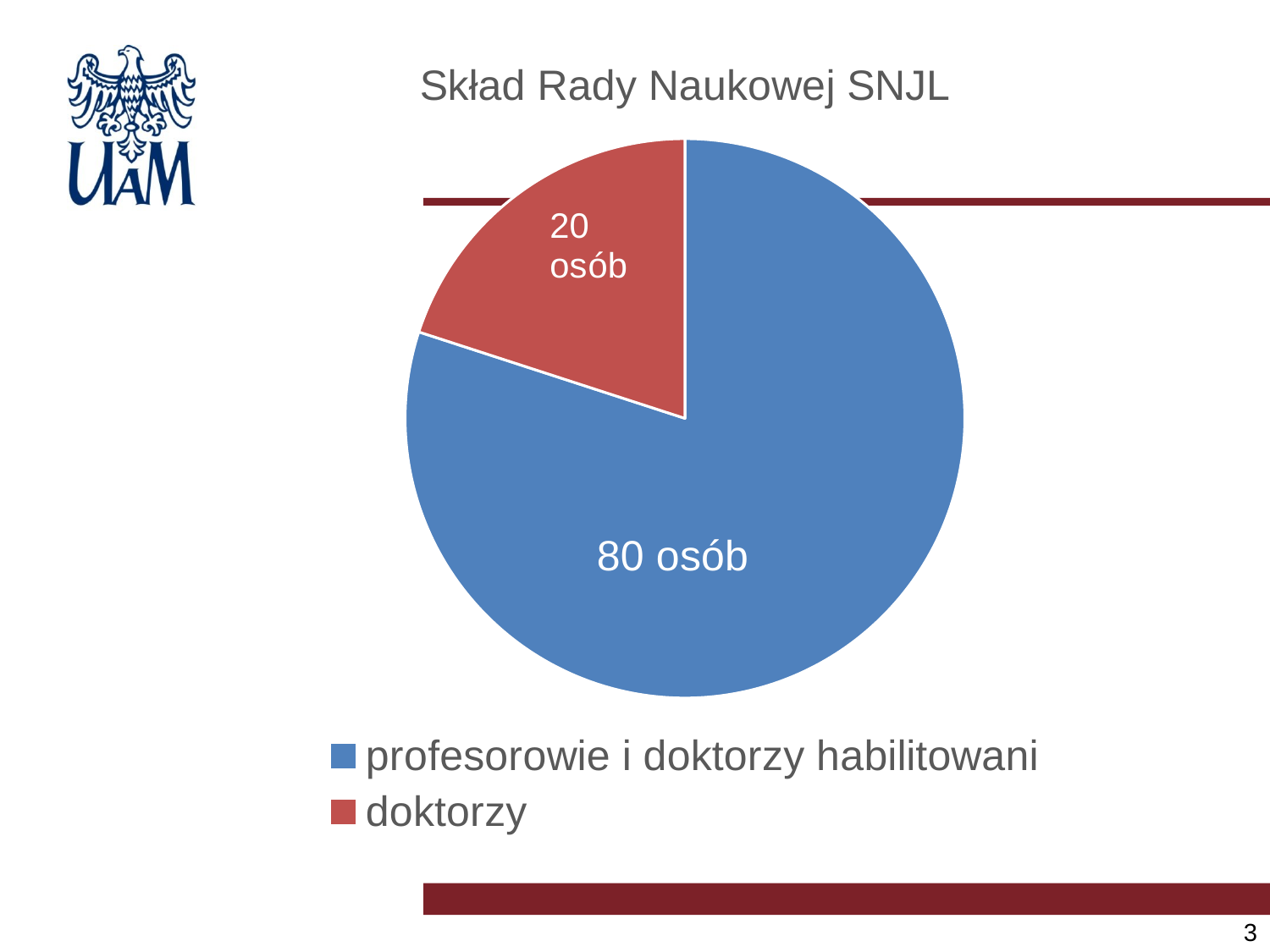
What colour is the slice for 'doktorzy'? red What is the title of the chart? Skład Rady Naukowej SNJL Which category has the smallest slice? doktorzy Which is larger, the value for 'doktorzy' or for 'profesorowie i doktorzy habilitowani'? profesorowie i doktorzy habilitowani What kind of chart is shown on the slide? pie chart How many slices does the pie chart have? 2 Which category has the largest slice? profesorowie i doktorzy habilitowani What is the difference between the values for 'profesorowie i doktorzy habilitowani' and 'doktorzy'? 60 osób How many entries does the legend list? 2 What is the value shown for 'profesorowie i doktorzy habilitowani'? 80 osób What is the value shown for 'doktorzy'? 20 osób What share of the pie does the 'doktorzy' slice represent? 20%